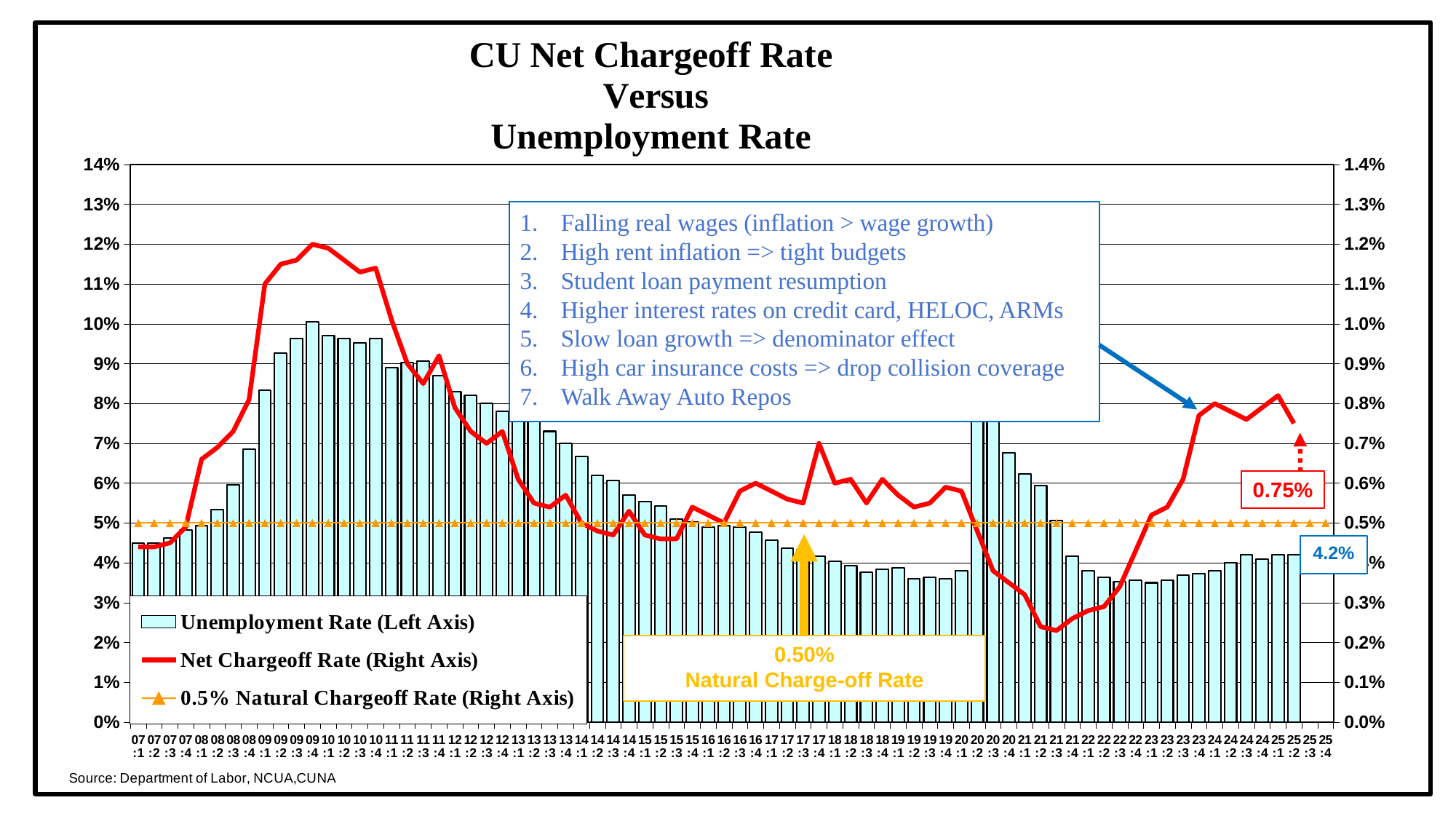
What kind of chart is shown on the slide? bar and line chart Does the unemployment rate rise or fall from 09:4 to 19:4? fall How many series does the legend list? 3 Which has the larger unemployment rate, 09:4 or 07:1? 09:4 What is the most recent net chargeoff rate value labeled on the chart? 0.75% Is the unemployment rate for 22:1 greater or less than 4%? less Is the net chargeoff rate for 09:4 greater or less than 1.1%? greater Is the unemployment rate for 09:3 greater or less than 9%? greater What is the most recent unemployment rate value labeled on the chart? 4.2% Which legend entry is drawn as the red line? Net Chargeoff Rate (Right Axis) What value is given for the natural charge-off rate? 0.50%